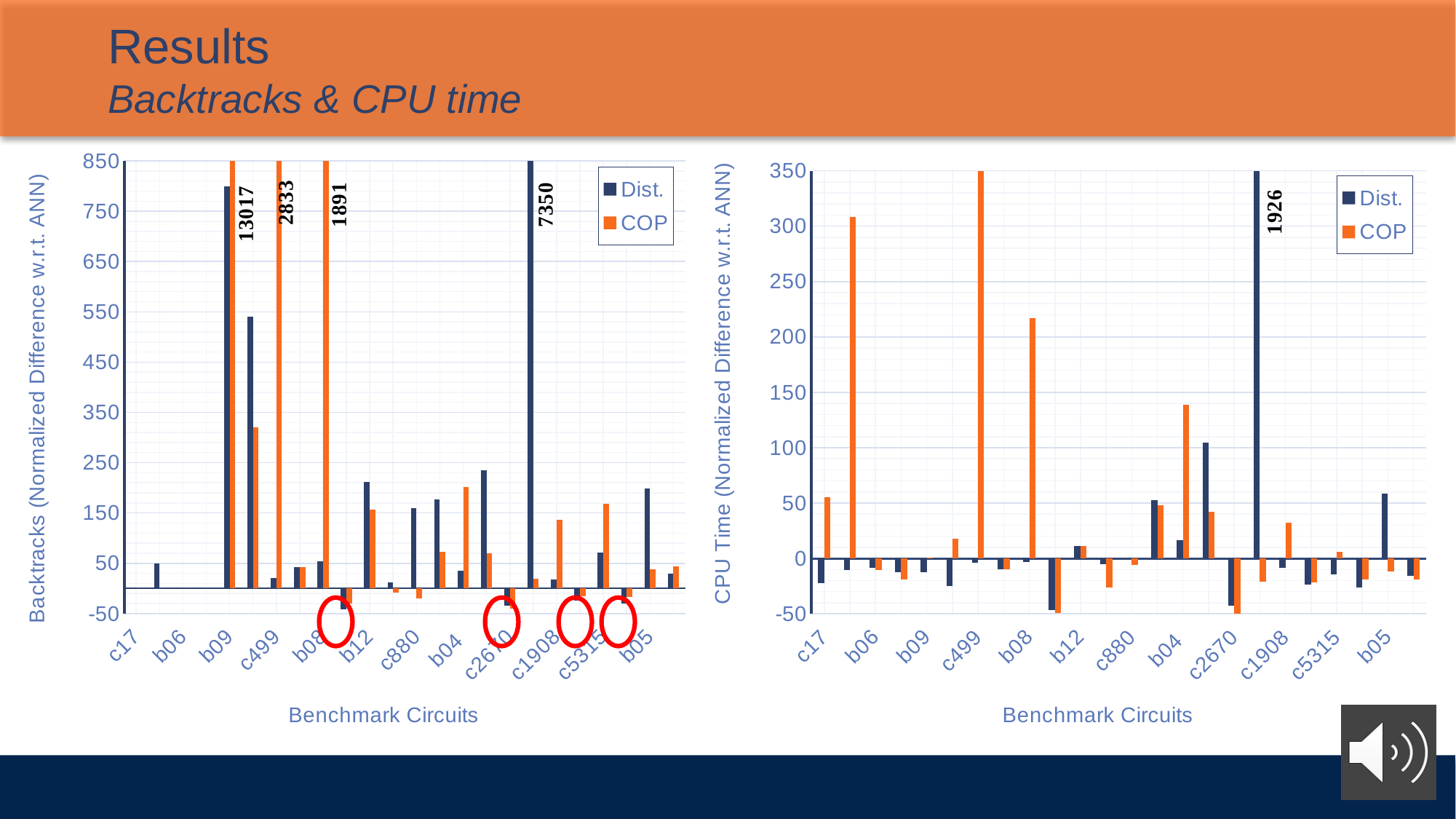
What is the largest data label printed on the left chart (Backtracks)? 13017 How many series does the legend of the right chart (CPU Time) list? 2 On the left chart (Backtracks), which series does the bar labeled 7350 belong to? Dist. On the left chart (Backtracks), what is the difference between the bars labeled 2833 and 1891? 942 How many data labels are printed on the left chart (Backtracks)? 4 What is the smallest data label printed on the left chart (Backtracks)? 1891 On the left chart (Backtracks), what is the difference between the bars labeled 13017 and 2833? 10184 On the left chart (Backtracks), which is larger: the bar labeled 13017 or the bar labeled 7350? 13017 What is the x-axis title of the right chart (CPU Time)? Benchmark Circuits What are the two legend entries on the left chart (Backtracks)? Dist. and COP What is the only data label printed on the right chart (CPU Time)? 1926 What kind of chart is the left chart (Backtracks)? bar chart